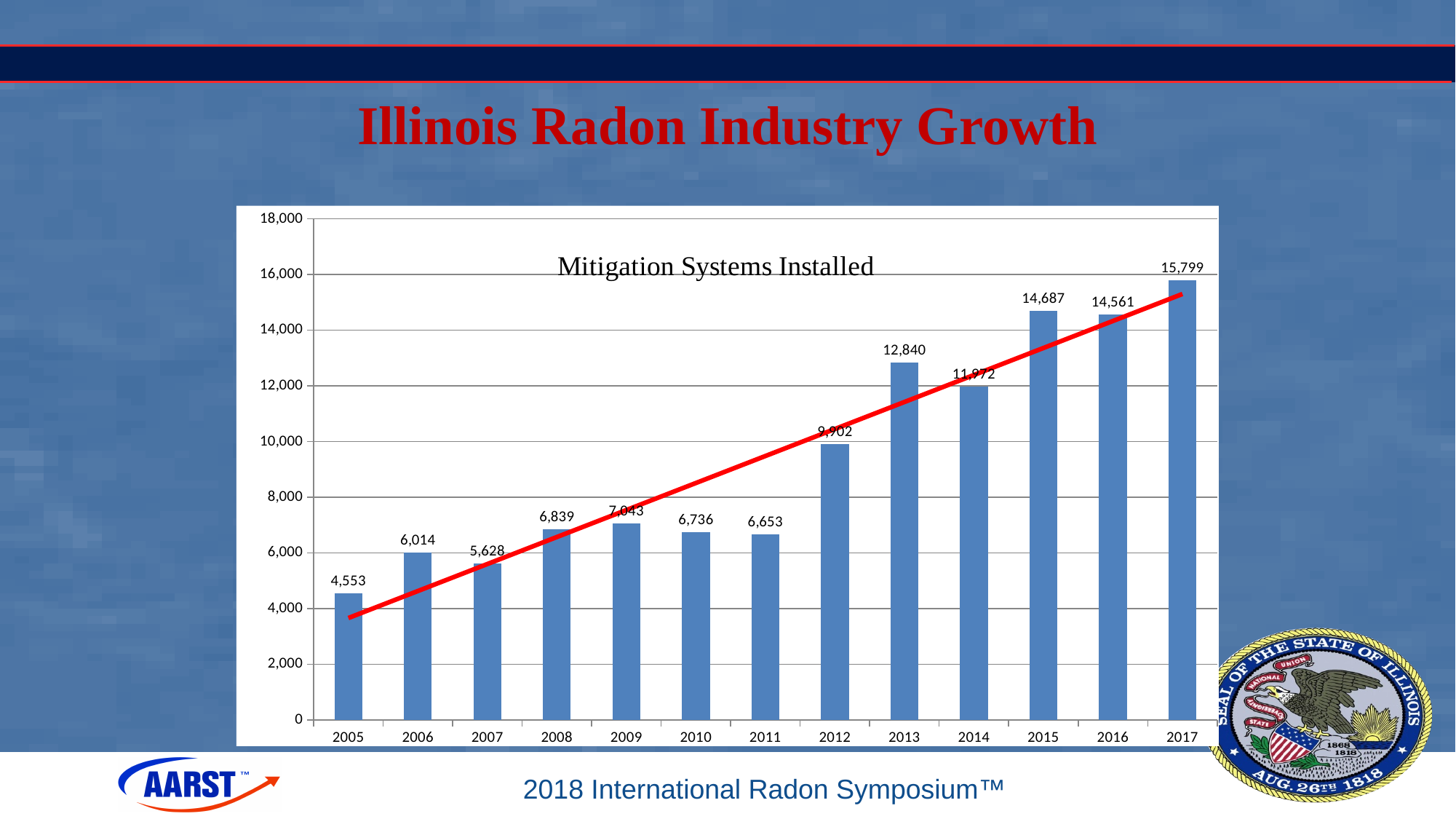
What is the value shown for 2017? 15,799 Which year has the larger value, 2015 or 2016? 2015 Which year has the lowest number of mitigation systems installed? 2005 How many mitigation systems were installed in 2005? 4,553 Is the value for 2012 greater or less than 8,000? greater How many years are shown on the x axis? 13 How many mitigation systems were installed in 2013? 12,840 What kind of chart is shown on the slide? bar chart Overall, do the values rise or fall from 2005 to 2017? rise What is the difference between the 2013 value and the 2008 value? 6,001 What is the difference between the 2017 value and the 2005 value? 11,246 Which year has the highest number of mitigation systems installed? 2017